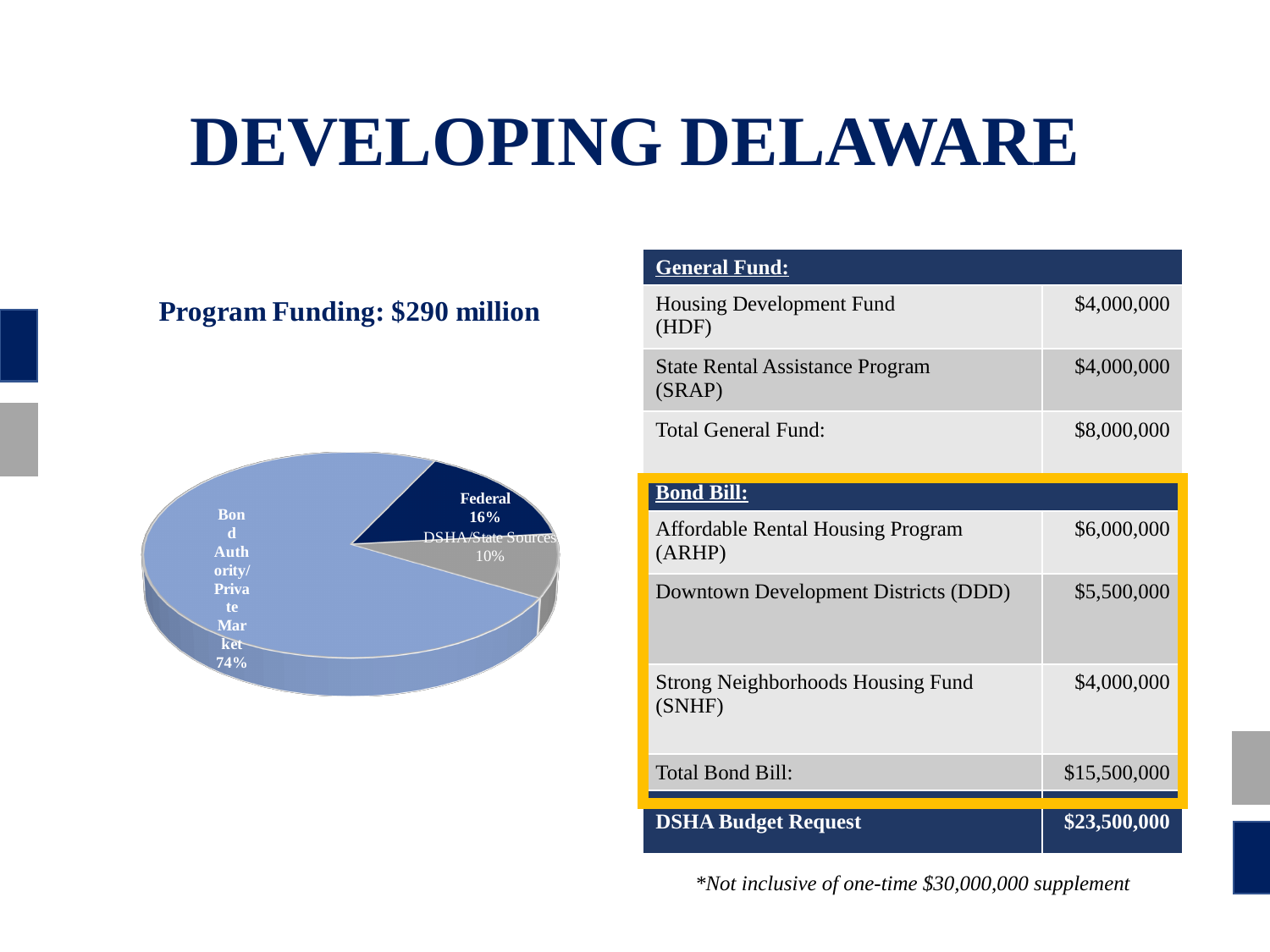
Which slice of the pie chart is the smallest? DSHA/State Sources What kind of chart is shown on the slide? pie chart What is the title of the pie chart? Program Funding: $290 million What share of program funding comes from Federal sources in the pie chart? 16% What share of program funding comes from Bond Authority/Private Market in the pie chart? 74% How many slices does the pie chart have? 3 What is the difference in percentage points between the Bond Authority/Private Market share and the Federal share in the pie chart? 58 Which slice of the pie chart is the largest? Bond Authority/Private Market What share of program funding comes from DSHA/State Sources in the pie chart? 10% What total program funding amount is stated in the pie chart's title? $290 million In the pie chart, which is larger: the Federal share or the DSHA/State Sources share? Federal What is the difference in percentage points between the Federal share and the DSHA/State Sources share in the pie chart? 6